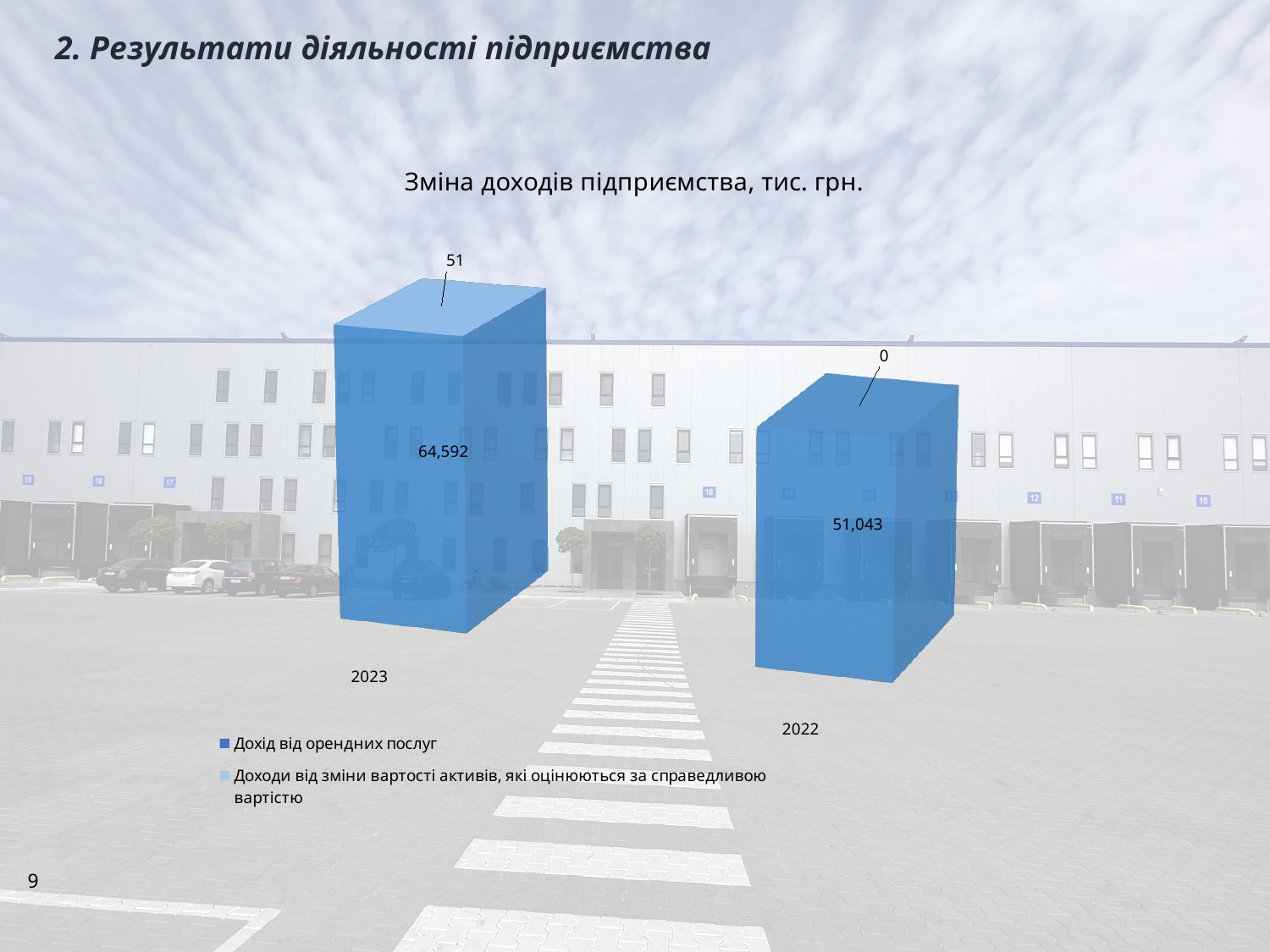
What is the value of 'Дохід від орендних послуг' for 2022? 51,043 Which year has the higher value for 'Дохід від орендних послуг'? 2023 What is the total of the stacked bar for 2023? 64,643 How many series does the legend list? 2 What is the value of 'Доходи від зміни вартості активів, які оцінюються за справедливою вартістю' for 2023? 51 What is the difference between the 'Дохід від орендних послуг' values for 2023 and 2022? 13,549 What is the value of 'Доходи від зміни вартості активів, які оцінюються за справедливою вартістю' for 2022? 0 What is the title of the chart? Зміна доходів підприємства, тис. грн. How many categories (years) are shown on the chart? 2 What is the value of 'Дохід від орендних послуг' for 2023? 64,592 Which series is shown in the lighter blue colour in the legend? Доходи від зміни вартості активів, які оцінюються за справедливою вартістю What type of chart is shown on the slide? bar chart